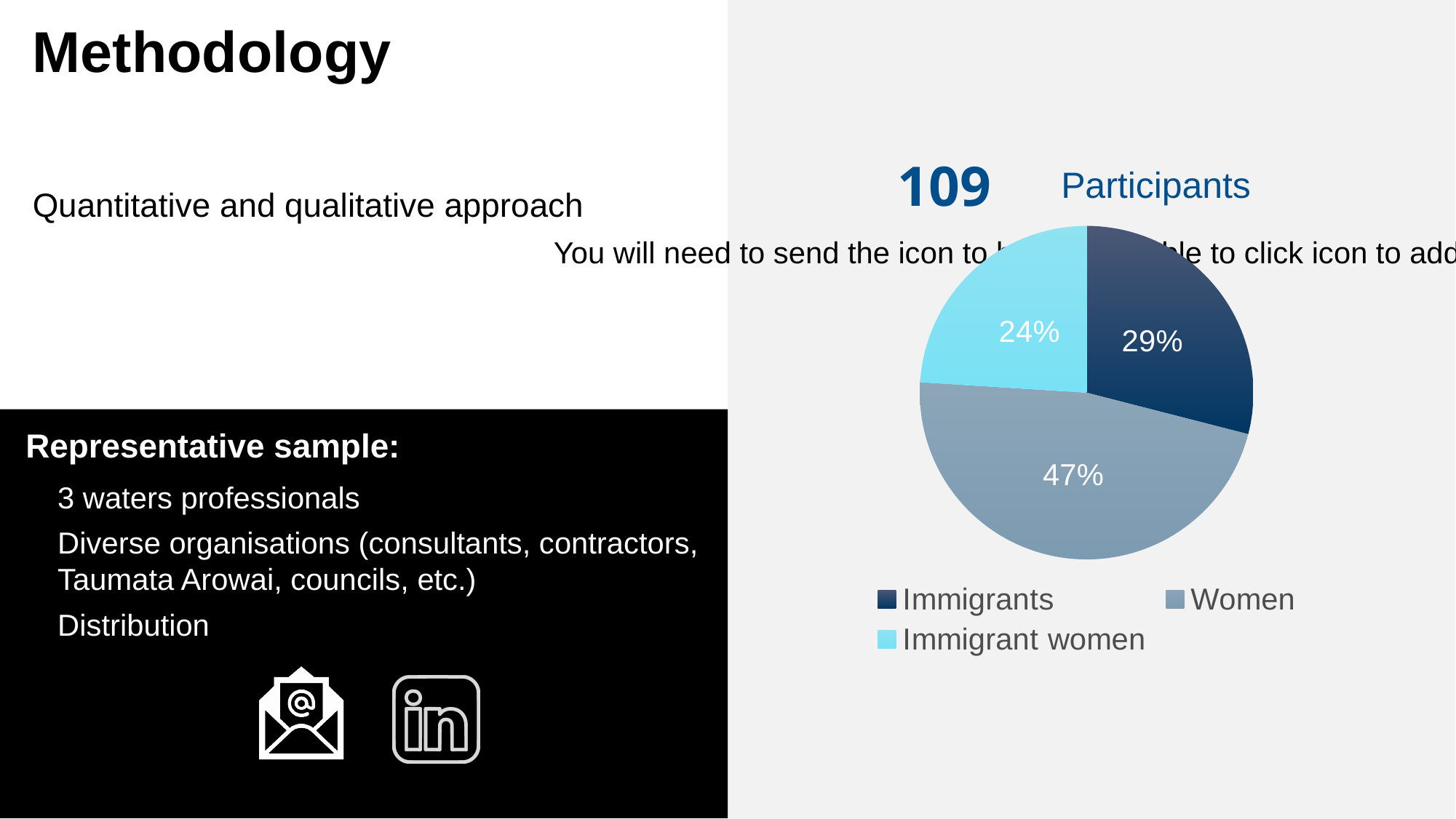
What is the difference in percentage points between Women and Immigrants? 18 How many slices does the pie chart have? 3 How many entries does the legend list? 3 Which category has the smallest share of the pie? Immigrant women What percentage of the pie is Immigrants? 29% What percentage of the pie is Immigrant women? 24% Which is larger, the share for Immigrants or the share for Immigrant women? Immigrants What percentage of the pie is Women? 47% How many participants does the slide state the chart is based on? 109 What kind of chart is shown on the slide? pie chart What is the difference in percentage points between Immigrants and Immigrant women? 5 Which category has the largest share of the pie? Women